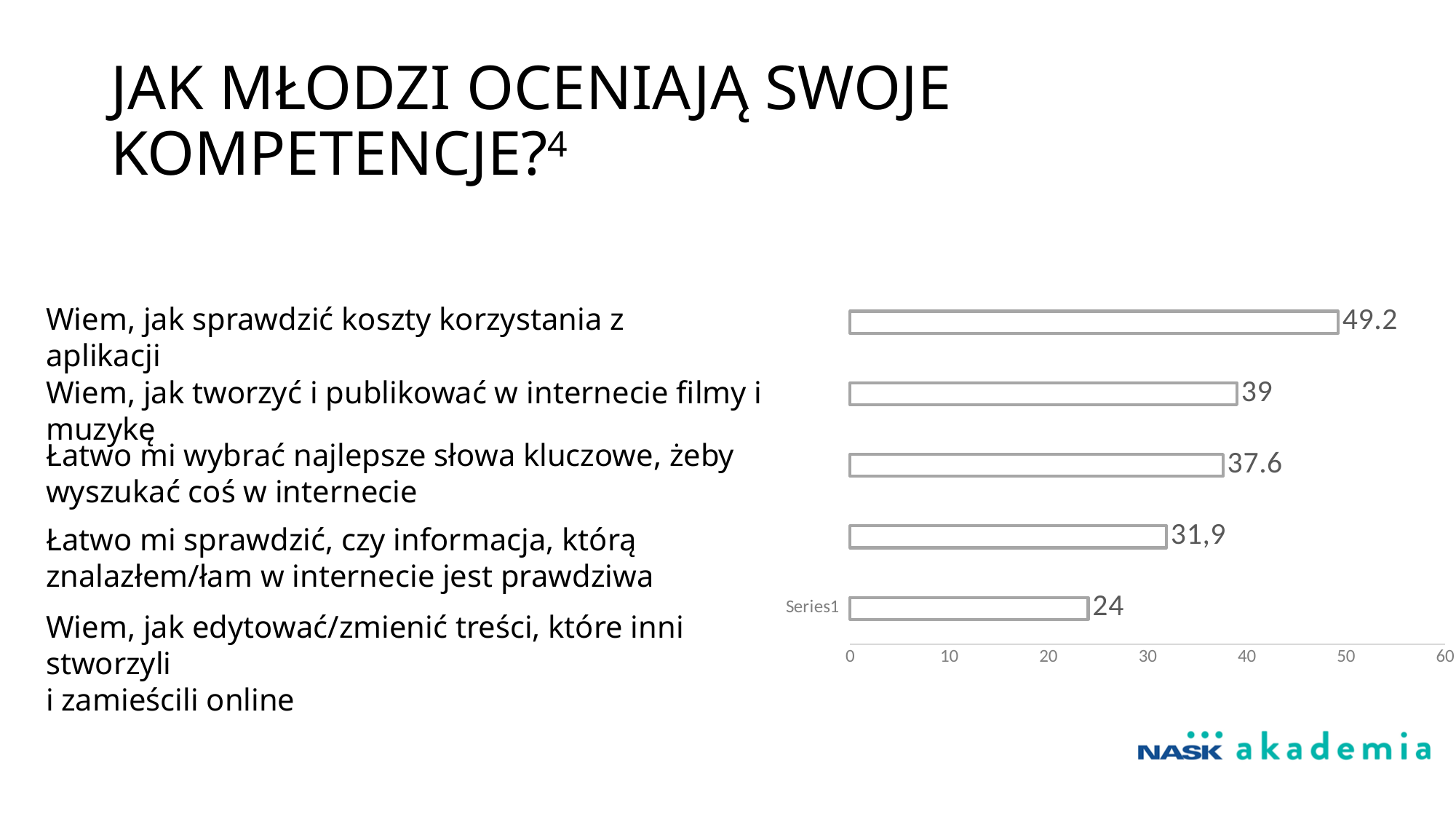
What is the maximum value shown on the chart's horizontal axis? 60 Which statement has the highest value? Wiem, jak sprawdzić koszty korzystania z aplikacji How many bars does the chart show? 5 Which statement has the lowest value? Wiem, jak edytować/zmienić treści, które inni stworzyli i zamieścili online What is the value for "Wiem, jak edytować/zmienić treści, które inni stworzyli i zamieścili online"? 24 What is the value for "Wiem, jak sprawdzić koszty korzystania z aplikacji"? 49.2 What is the value for "Łatwo mi sprawdzić, czy informacja, którą znalazłem/łam w internecie jest prawdziwa"? 31,9 What kind of chart is shown on the slide? bar chart What is the difference between the value for "Wiem, jak sprawdzić koszty korzystania z aplikacji" and the value for "Wiem, jak edytować/zmienić treści, które inni stworzyli i zamieścili online"? 25.2 What is the value for "Łatwo mi wybrać najlepsze słowa kluczowe, żeby wyszukać coś w internecie"? 37.6 What is the value for "Wiem, jak tworzyć i publikować w internecie filmy i muzykę"? 39 Which is larger: the value for "Wiem, jak tworzyć i publikować w internecie filmy i muzykę" or the value for "Łatwo mi sprawdzić, czy informacja, którą znalazłem/łam w internecie jest prawdziwa"? Wiem, jak tworzyć i publikować w internecie filmy i muzykę